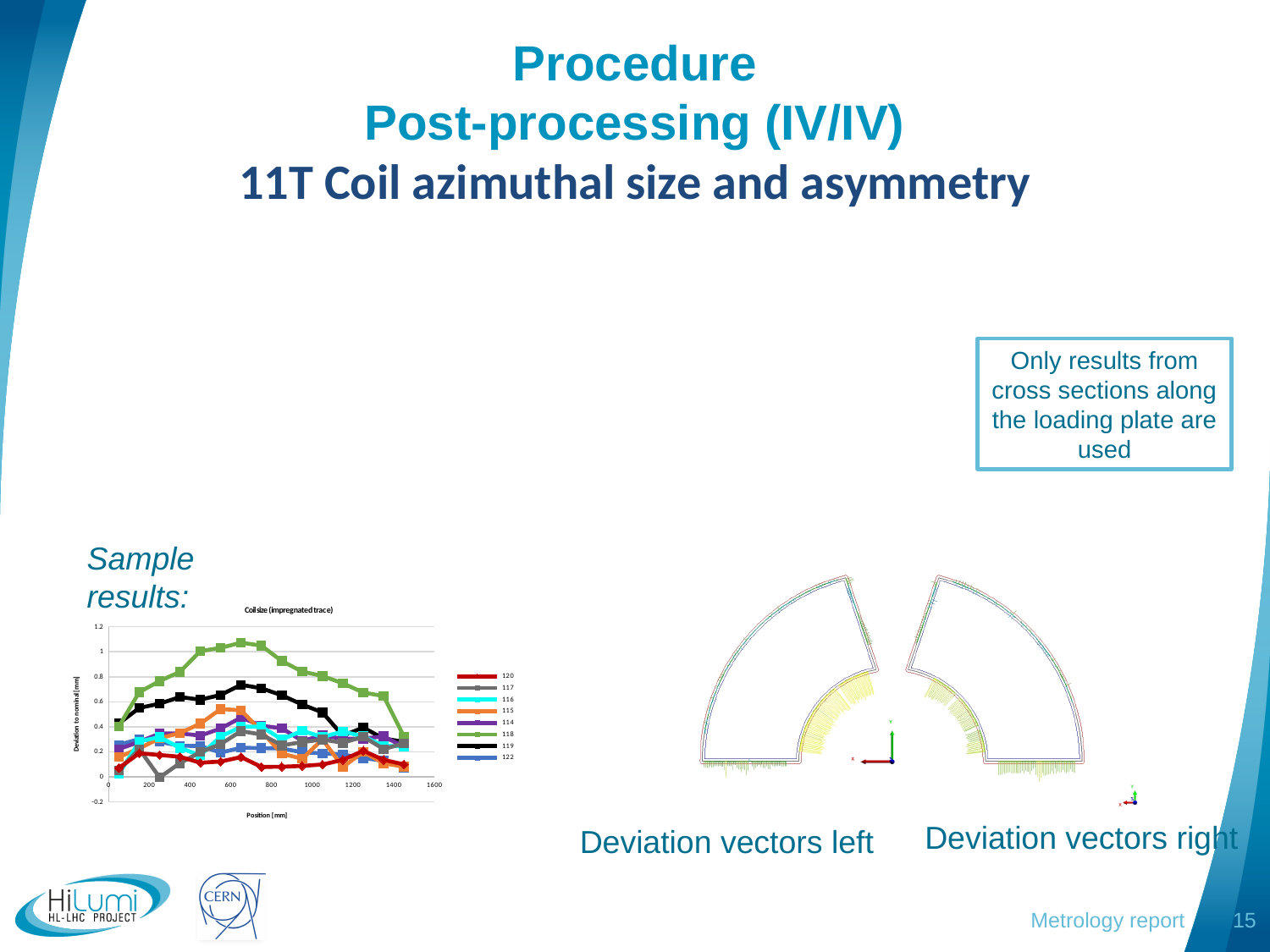
What is the label of the x axis of the 'Coil size (impregnated trace)' chart? Position [mm] In the 'Coil size (impregnated trace)' chart, is the value for series 119 at position 600 greater or less than 0.6? greater What is the label of the y axis of the 'Coil size (impregnated trace)' chart? Deviation to nominal [mm] In the 'Coil size (impregnated trace)' chart, does series 118 rise or fall between position 800 and position 1400? fall In the 'Coil size (impregnated trace)' chart, which series has the larger value at position 600, 118 or 120? 118 What type of chart is the 'Coil size (impregnated trace)' chart? line chart How many series does the legend of the 'Coil size (impregnated trace)' chart list? 8 In the 'Coil size (impregnated trace)' chart, is the value for series 118 at position 1000 greater or less than 0.6? greater In the 'Coil size (impregnated trace)' chart, is the peak value of series 118 greater or less than 1? greater In the 'Coil size (impregnated trace)' chart, does series 118 rise or fall between position 0 and position 600? rise In the 'Coil size (impregnated trace)' chart, which series reaches the highest deviation to nominal? 118